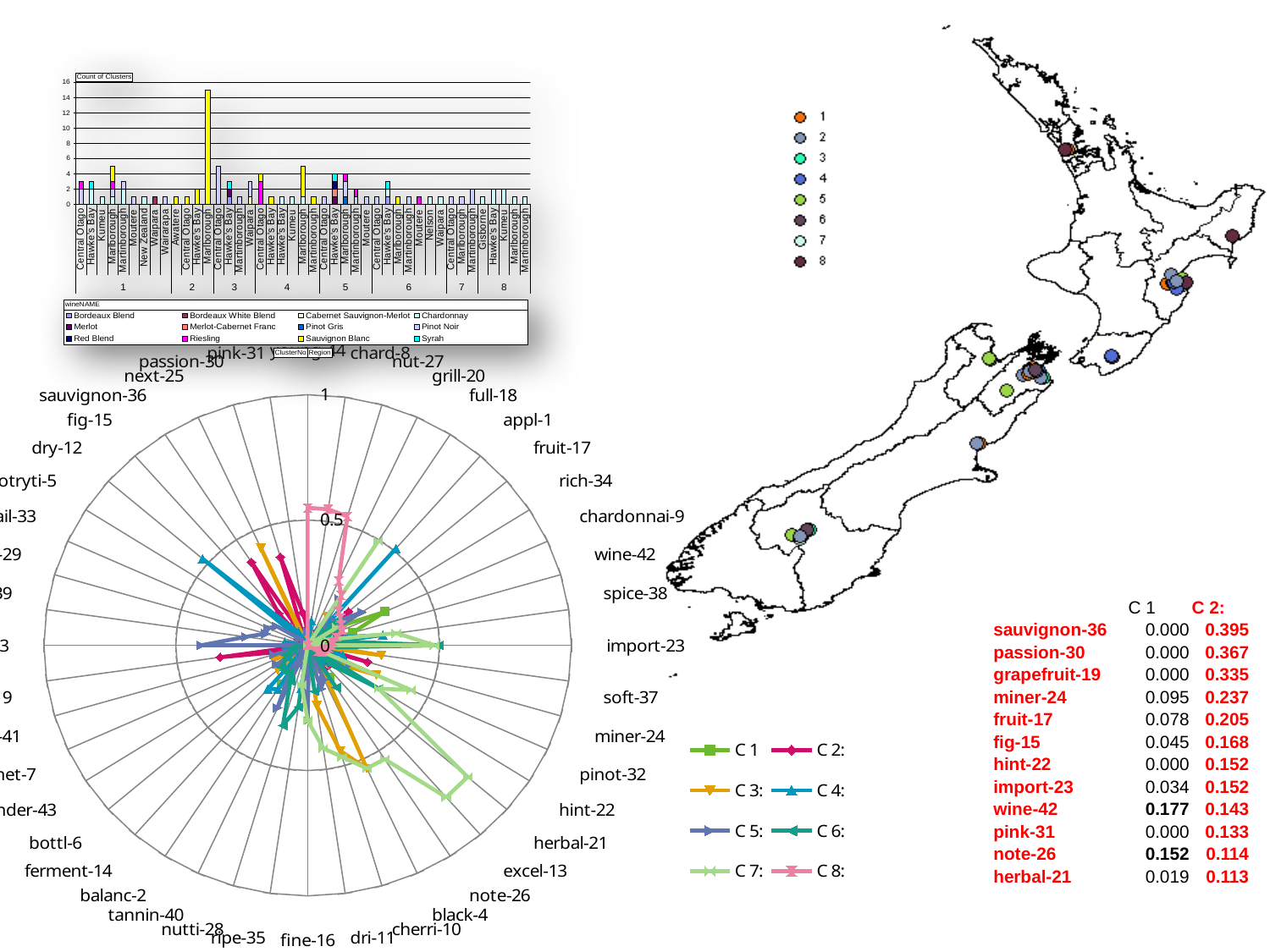
How many series does the legend of the radar chart list? 8 What is the highest tick value shown on the radial axis of the radar chart? 1 What kind of chart is the small chart at the top left of the slide? bar chart What is the title of the small bar chart at the top left of the slide? Count of Clusters According to the table of radar chart values at the bottom right, what is the C 2 value for sauvignon-36? 0.395 In the top-left 'Count of Clusters' bar chart, is the tallest bar greater or less than 10? greater According to the table of radar chart values at the bottom right, what is the C 1 value for wine-42? 0.177 In the top-left 'Count of Clusters' bar chart, which cluster group contains the tallest bar? 2 What kind of chart is the large chart on the left with the circular grid and labels such as sauvignon-36 and fruit-17? radar chart According to the table at the bottom right, which is larger for note-26, the C 1 value or the C 2 value? C 1 How many wine names does the legend of the top-left 'Count of Clusters' bar chart list? 12 What are the legend entries of the radar chart? C 1, C 2:, C 3:, C 4:, C 5:, C 6:, C 7:, C 8: